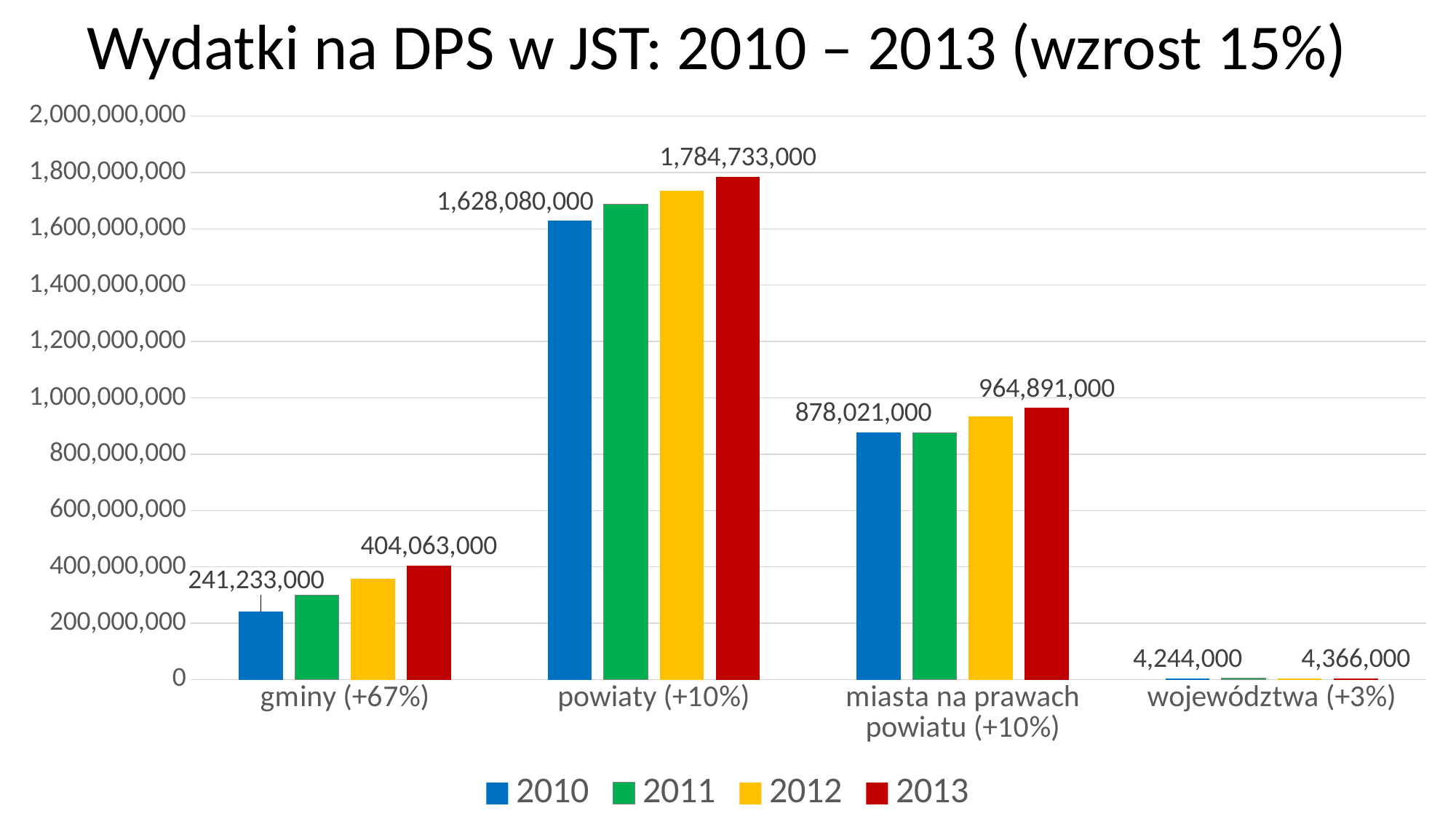
What is the value for województwa in 2013? 4,366,000 What is the value for gminy in 2010? 241,233,000 Is the value for gminy in 2012 greater or less than 400,000,000? less What type of chart is shown on the slide? bar chart What is the difference between the 2013 and 2010 values for miasta na prawach powiatu? 86,870,000 Which is larger: the 2013 value for gminy or the 2010 value for miasta na prawach powiatu? the 2010 value for miasta na prawach powiatu How many series does the legend list? 4 What is the value for powiaty in 2013? 1,784,733,000 What is the value for miasta na prawach powiatu in 2010? 878,021,000 What is the difference between the 2013 and 2010 values for gminy? 162,830,000 Which category has the highest value in 2013? powiaty (+10%) Which category has the lowest value in 2010? województwa (+3%)